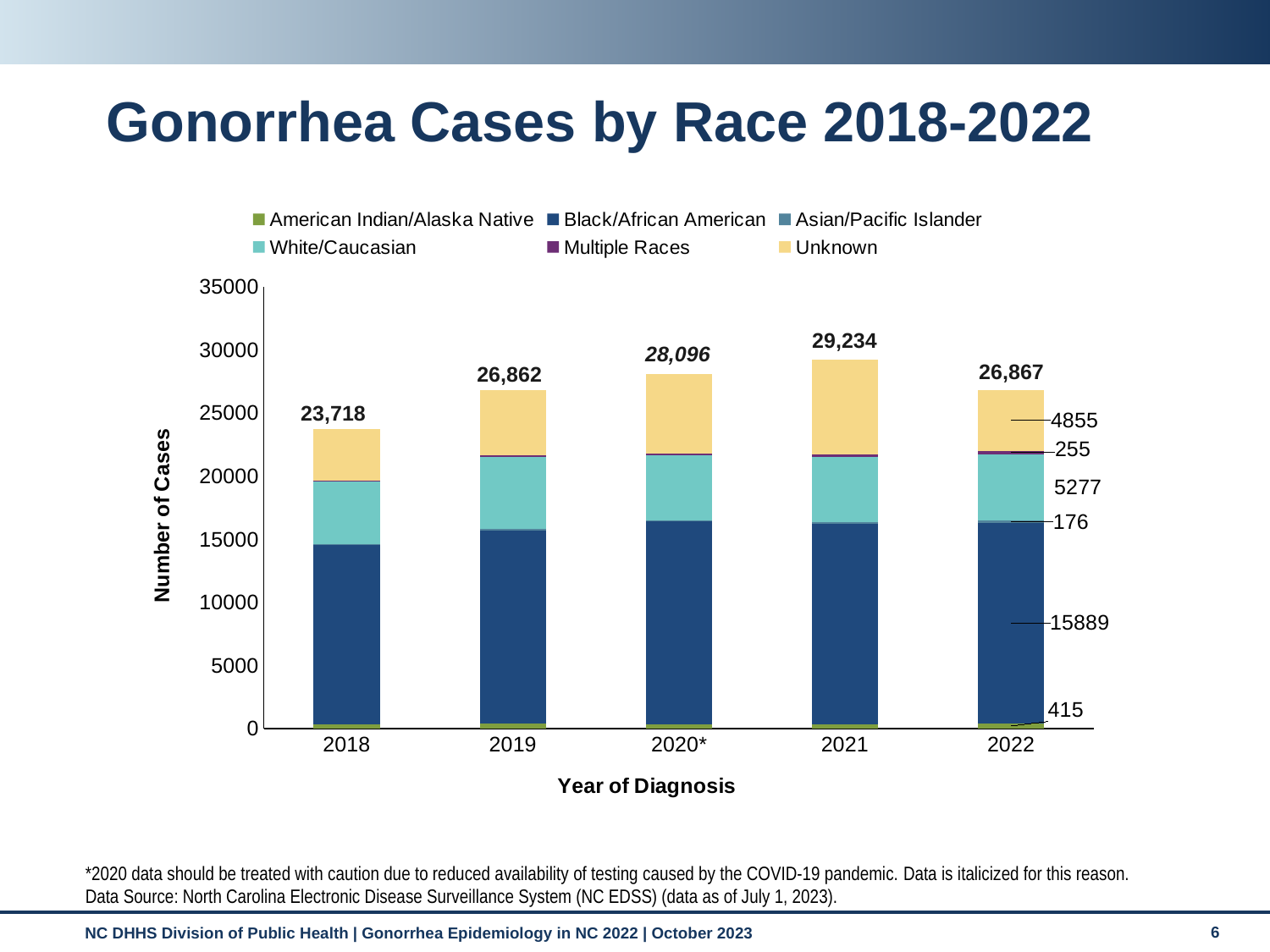
How many years are shown on the x axis? 5 How many cases are labeled for the White/Caucasian segment of the 2022 bar? 5277 What is the total number of cases shown for 2018? 23,718 Which year has the highest total number of cases? 2021 What kind of chart is shown on the slide? Stacked bar chart What is the difference between the total cases in 2021 and in 2018? 5,516 How many cases are labeled for the Black/African American segment of the 2022 bar? 15889 How many cases are labeled for the Unknown segment of the 2022 bar? 4855 What is the total number of gonorrhea cases shown for 2021? 29,234 Which year has the lowest total number of cases? 2018 Which year has more total cases, 2020* or 2019? 2020* How many race categories does the legend list? 6